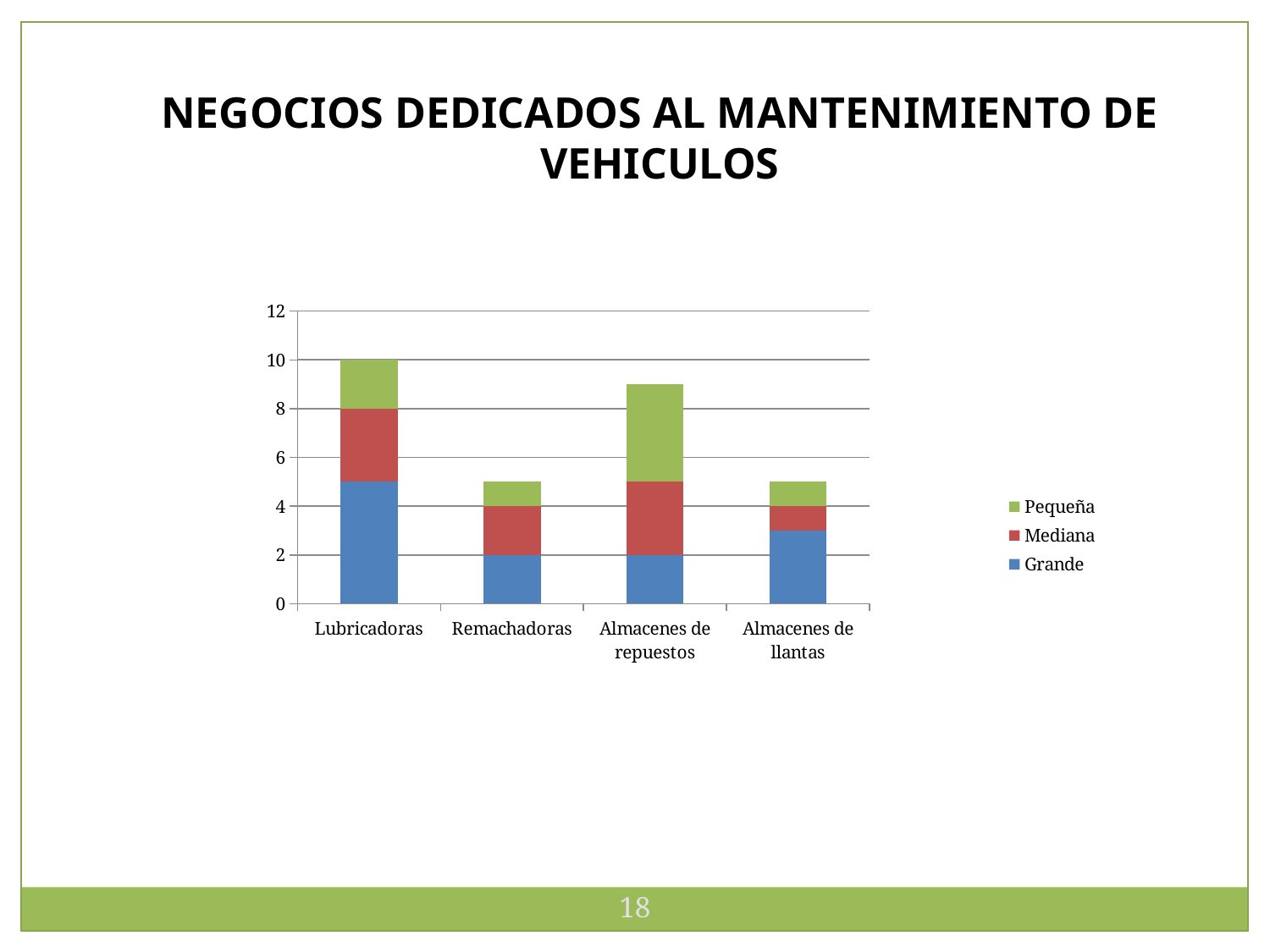
How many business categories are shown on the x axis? 4 Which has the larger Grande value, Lubricadoras or Almacenes de llantas? Lubricadoras What kind of chart is shown on the slide? Stacked bar chart Which series is shown in green in the legend? Pequeña Is the Grande value for Almacenes de llantas greater or less than 4? less Is the total for Almacenes de repuestos greater or less than 8? greater Which category has the tallest stacked bar? Lubricadoras What is the Grande value for Almacenes de repuestos? 2 What is the Grande value for Remachadoras? 2 How many series does the legend list? 3 What is the total height of the stacked bar for Lubricadoras? 10 Is the total for Remachadoras greater or less than 6? less